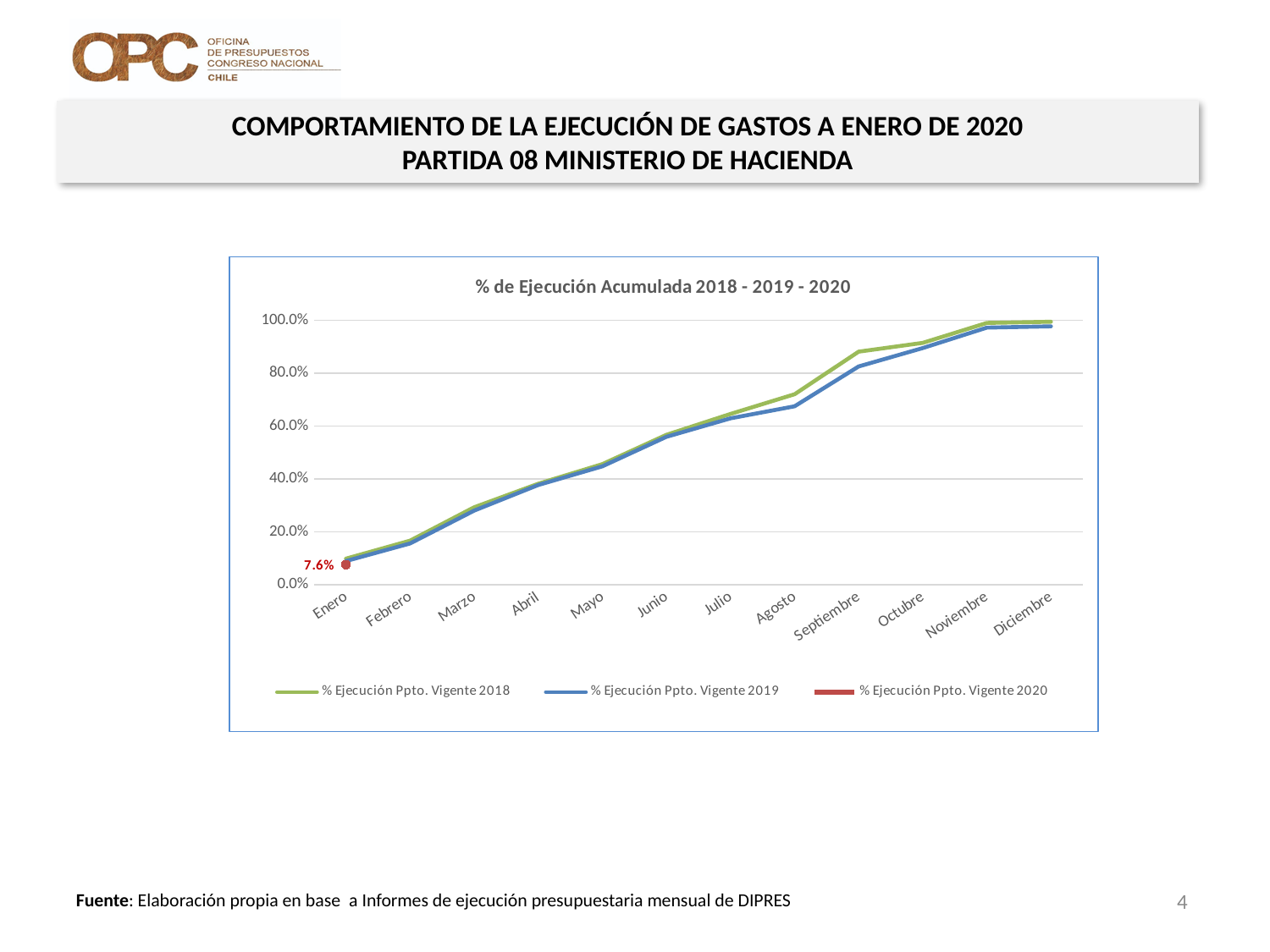
How many series does the legend list? 3 Is the value for % Ejecución Ppto. Vigente 2019 in Mayo greater or less than 40.0%? greater What is the value for % Ejecución Ppto. Vigente 2020 in Enero? 7.6% Is the value for % Ejecución Ppto. Vigente 2018 in Septiembre greater or less than 80.0%? greater Which month has the lowest value for % Ejecución Ppto. Vigente 2019? Enero How many months are shown along the x axis? 12 What is the title of the chart? % de Ejecución Acumulada 2018 - 2019 - 2020 Do the values for % Ejecución Ppto. Vigente 2019 rise or fall from Enero to Diciembre? rise In Septiembre, which series has the higher value: % Ejecución Ppto. Vigente 2018 or % Ejecución Ppto. Vigente 2019? % Ejecución Ppto. Vigente 2018 Is the value for % Ejecución Ppto. Vigente 2019 in Agosto greater or less than 80.0%? less Which month has the highest value for % Ejecución Ppto. Vigente 2018? Diciembre What kind of chart is shown on the slide? line chart